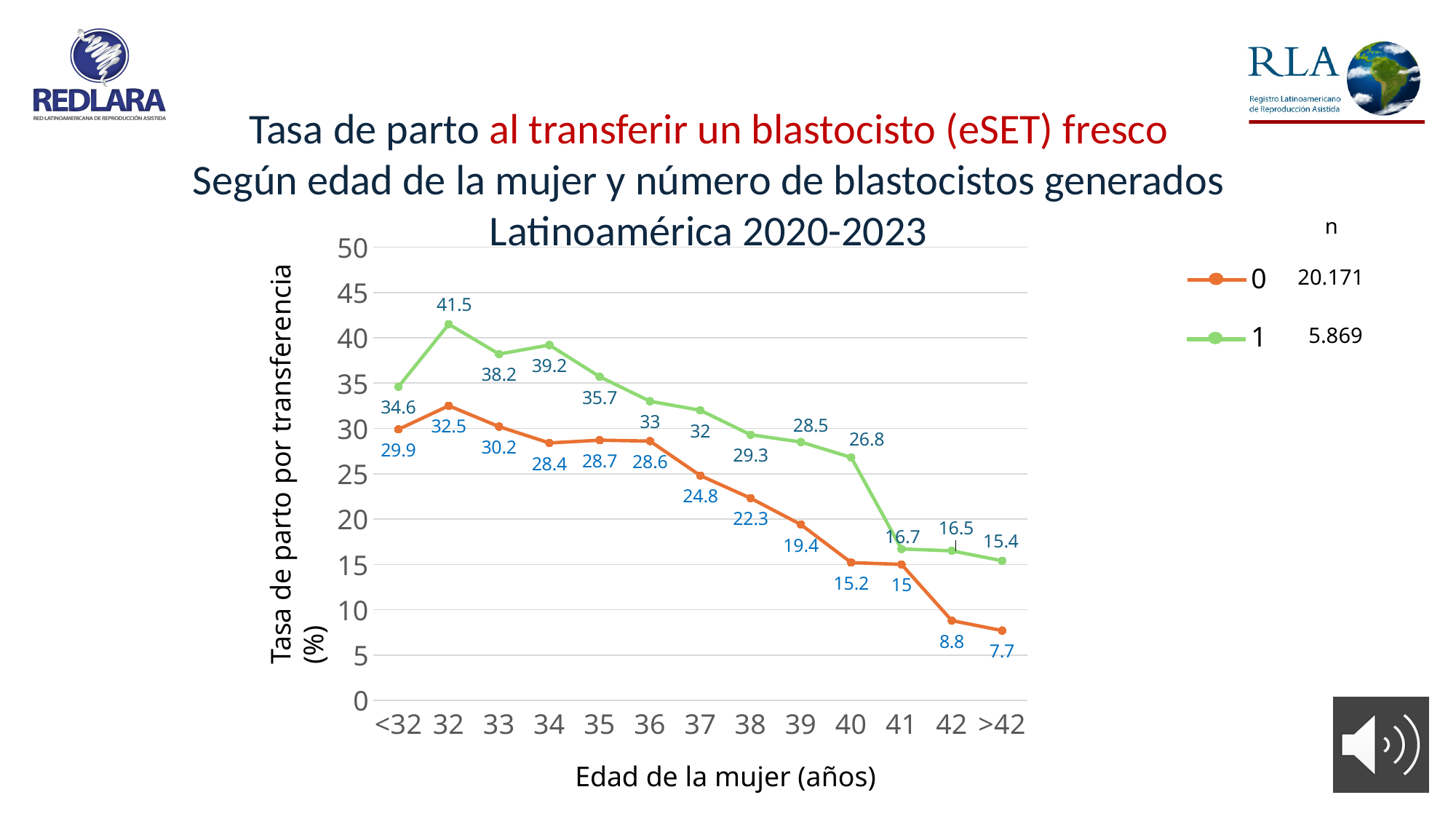
What is the value for series 1 at age 32? 41.5 Which is larger at age 34: the value for series 0 or series 1? Series 1 At which age category does series 0 reach its highest value? 32 How many age categories are shown on the x axis? 13 Do the values for series 0 generally rise or fall from age 32 to >42? Fall What is the value for series 1 at age >42? 15.4 How many series does the legend list? 2 What is the difference between series 1 and series 0 at age 40? 11.6 What kind of chart is shown on the slide? Line chart What is the value for series 0 at age 39? 19.4 At which age category does series 1 have its lowest value? >42 What is the n value shown in the legend for series 0? 20.171